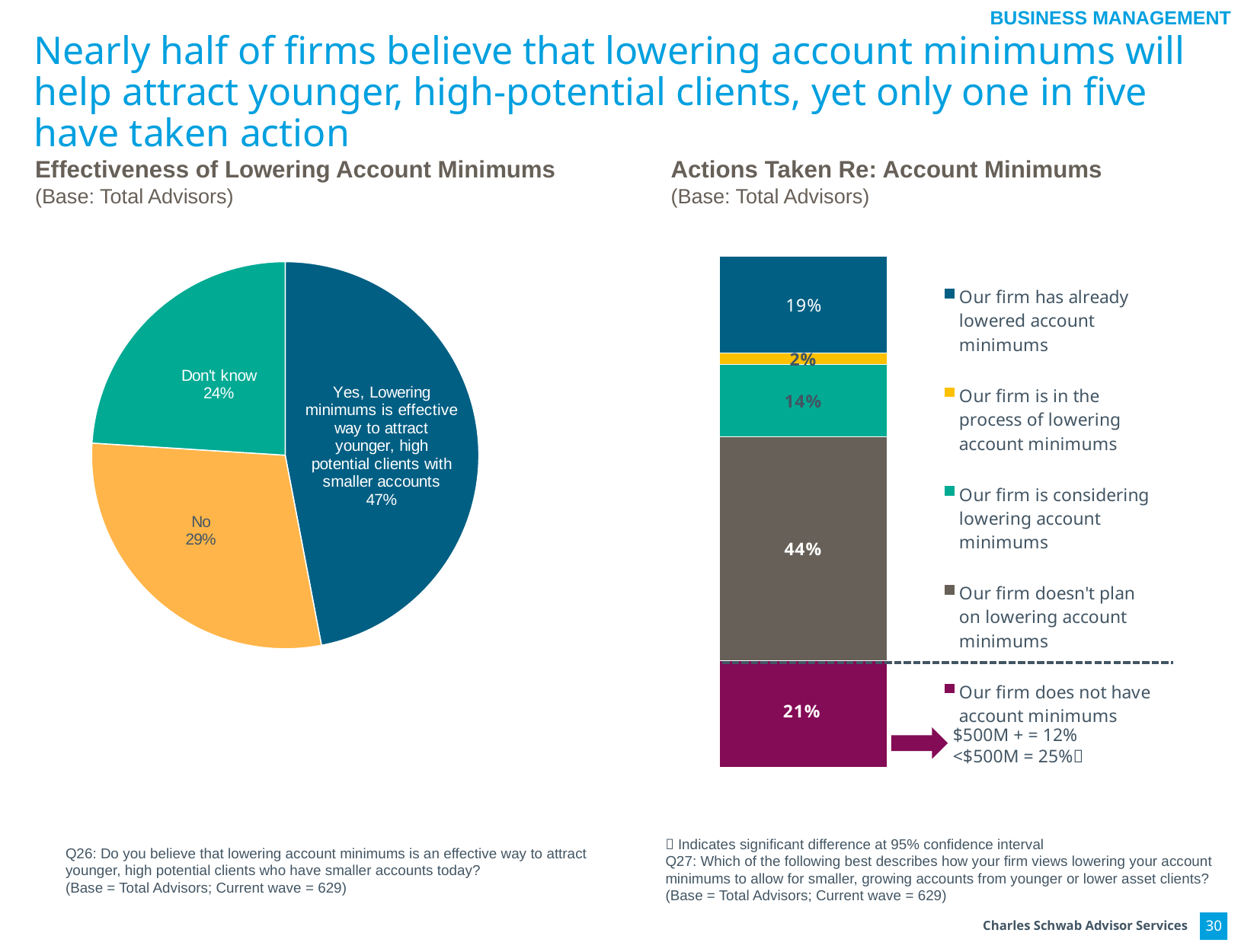
In the 'Actions Taken Re: Account Minimums' chart, which category has the largest value? Our firm doesn't plan on lowering account minimums In the 'Effectiveness of Lowering Account Minimums' chart, what share of advisors answered 'Don't know'? 24% In the 'Effectiveness of Lowering Account Minimums' chart, what is the difference in percentage points between the 'Yes' slice and the 'No' slice? 18 How many series does the legend of the 'Actions Taken Re: Account Minimums' chart list? 5 In the 'Effectiveness of Lowering Account Minimums' chart, which response has the largest slice? Yes, Lowering minimums is effective way to attract younger, high potential clients with smaller accounts How many slices does the 'Effectiveness of Lowering Account Minimums' pie chart have? 3 In the 'Actions Taken Re: Account Minimums' chart, what percentage of firms are in the process of lowering account minimums? 2% In the 'Effectiveness of Lowering Account Minimums' chart, what share of advisors answered 'No'? 29% In the 'Actions Taken Re: Account Minimums' chart, what percentage of firms have already lowered account minimums? 19% In the 'Actions Taken Re: Account Minimums' chart, which is larger: the share of firms considering lowering account minimums or the share that does not have account minimums? Our firm does not have account minimums In the 'Effectiveness of Lowering Account Minimums' chart, which response has the smallest slice? Don't know What type of chart is 'Effectiveness of Lowering Account Minimums'? Pie chart